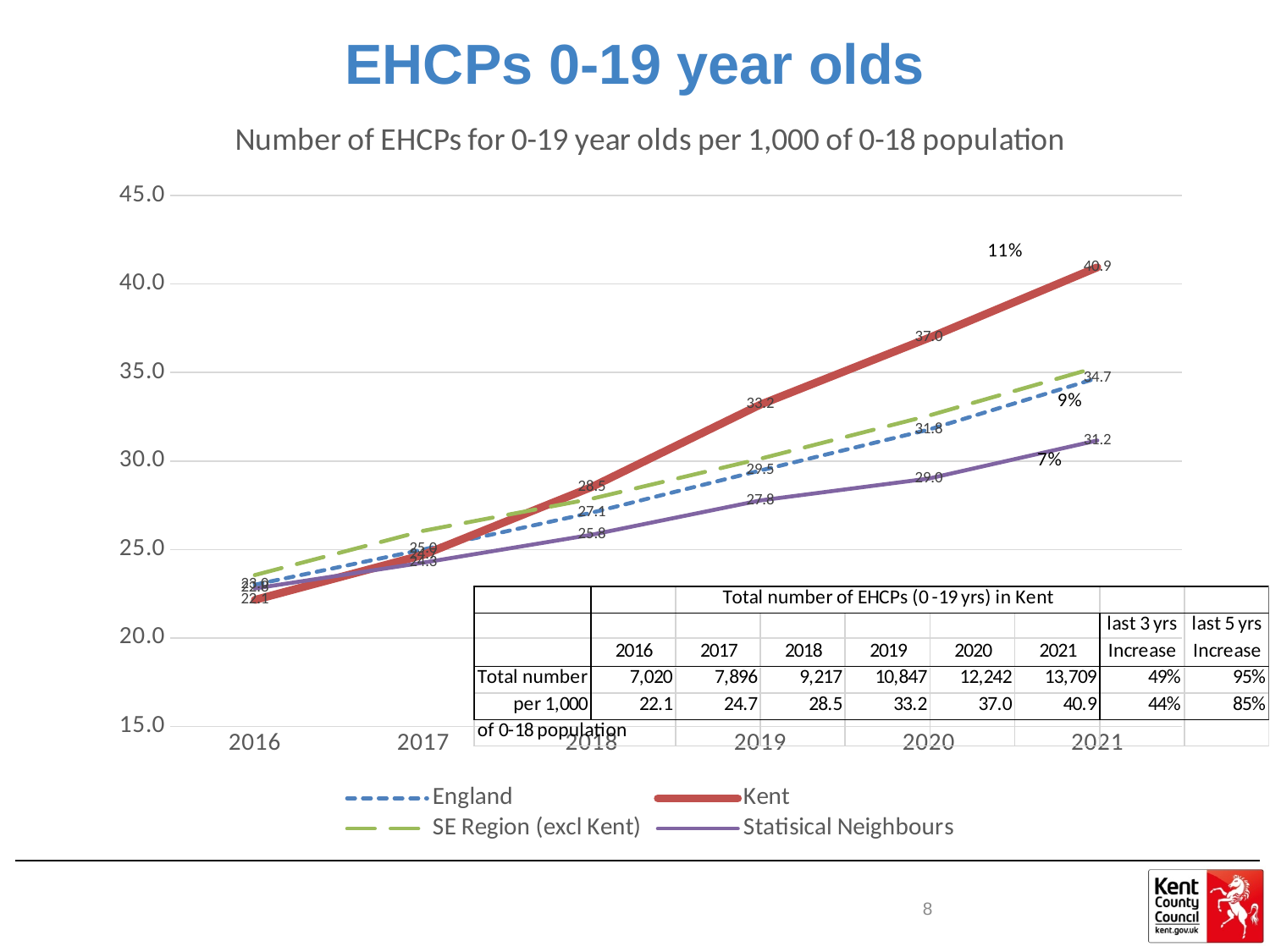
What is the value for Statistical Neighbours in 2021? 31.2 Which series has the lowest value in 2021? Statistical Neighbours Which series has the highest value in 2021? Kent Is the value for SE Region (excl Kent) in 2021 greater or less than 30.0? greater How many series does the legend list? 4 Does the Kent line rise or fall from 2016 to 2021? rises What kind of chart is shown on the slide? line chart What is the value for Kent in 2016? 22.1 What is the value for Kent in 2021? 40.9 What is the value for Kent in 2019? 33.2 What is the difference between the Kent values for 2020 and 2019? 3.8 By how much did the Kent value increase from 2016 to 2021? 18.8